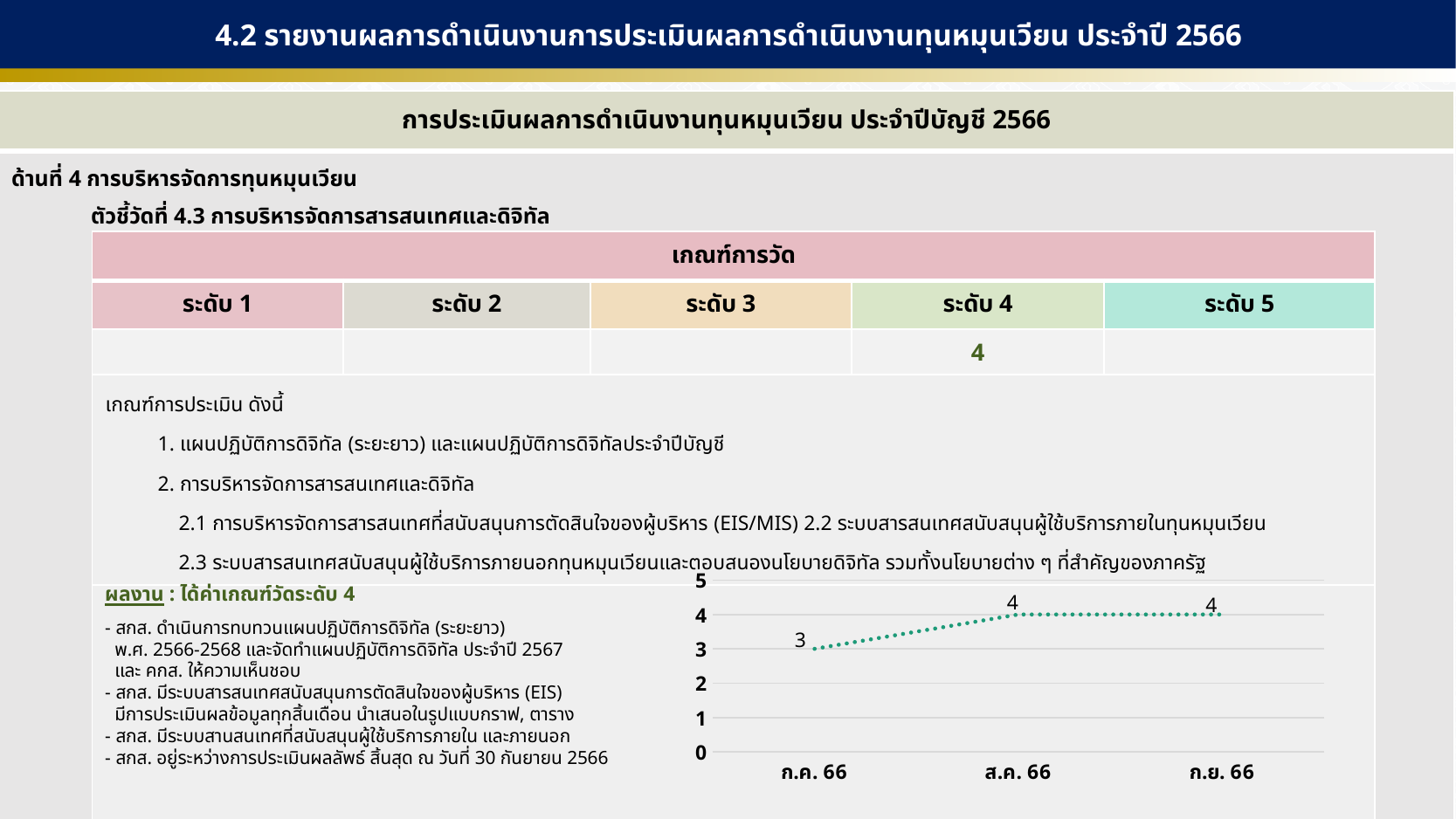
What is the difference between the values for ส.ค. 66 and ก.ค. 66? 1 Which is larger, the value for ก.ค. 66 or the value for ก.ย. 66? ก.ย. 66 How many data points are plotted on the chart? 3 What is the value for ก.ค. 66 on the chart? 3 Do the values rise or fall from ก.ค. 66 to ส.ค. 66? rise What is the highest value shown on the chart's vertical axis? 5 What is the value for ก.ย. 66 on the chart? 4 What kind of chart is shown on the slide? line chart Which month has the lowest value on the chart? ก.ค. 66 What colour is the line on the chart? green What is the value for ส.ค. 66 on the chart? 4 Is the value for ก.ค. 66 greater or less than 4? less